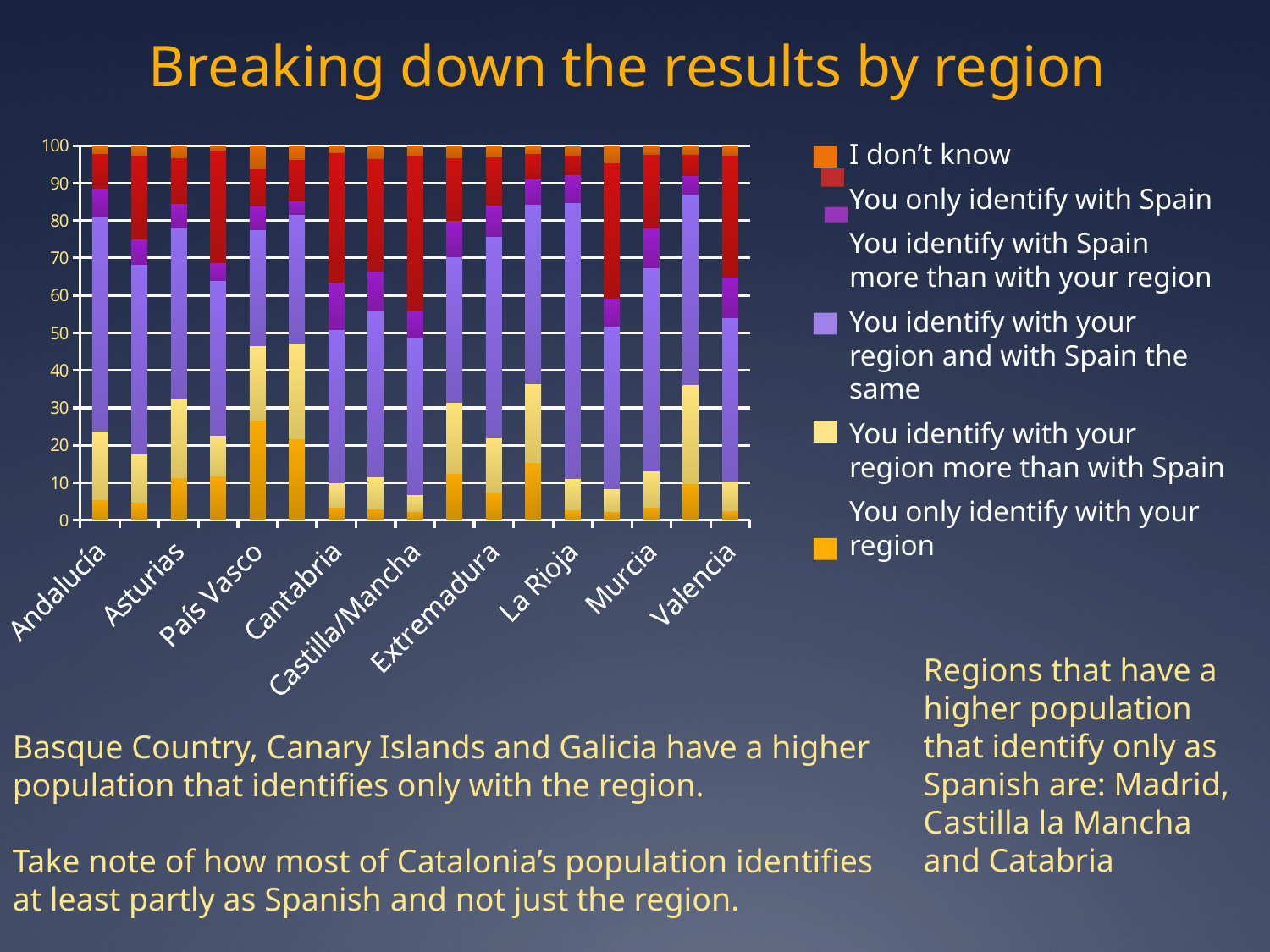
Among the labelled regions, which has the highest 'You only identify with your region' value? País Vasco Which has a larger 'You only identify with Spain' value, Castilla/Mancha or La Rioja? Castilla/Mancha What kind of chart is shown on the slide? stacked bar chart How many bars are plotted in the chart? 17 Which has a larger 'You only identify with your region' value, País Vasco or Andalucía? País Vasco Is the 'You only identify with your region' value for Andalucía greater or less than 10? less Is the 'You only identify with your region' value for País Vasco greater or less than 20? greater Which legend entry is shown in orange at the bottom of each bar? You only identify with your region Is the 'You only identify with your region' value for Cantabria greater or less than 10? less What is the title of the slide containing the chart? Breaking down the results by region How many series does the chart's legend list? 6